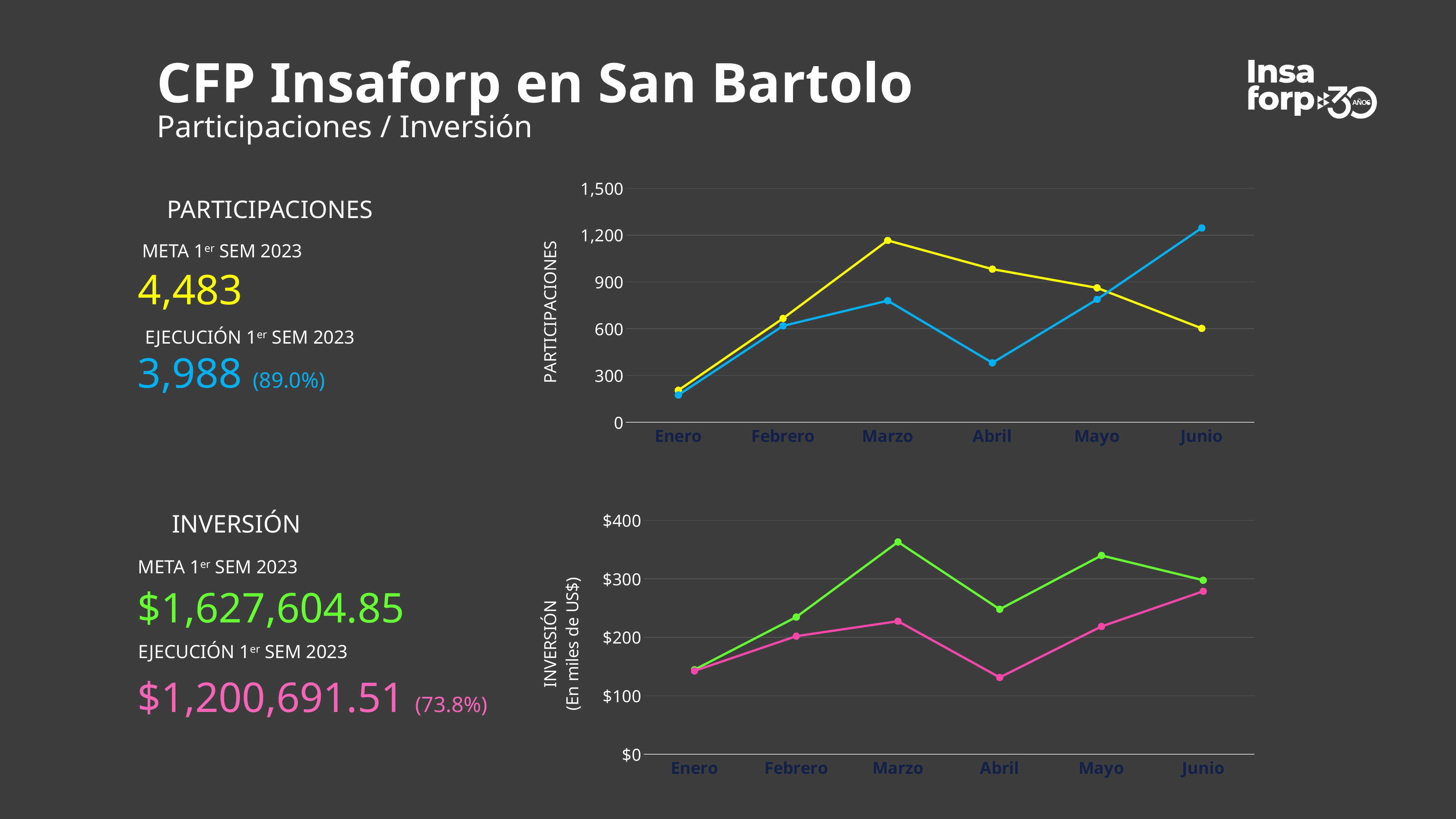
In the top chart (PARTICIPACIONES), does the yellow line rise or fall from Marzo to Junio? fall In the top chart (PARTICIPACIONES), in which month does the yellow line reach its highest value? Marzo In the top chart (PARTICIPACIONES), is the value of the blue line for Junio greater or less than 1,200? greater How many months are shown on the x axis of the bottom chart (INVERSIÓN)? 6 In the bottom chart (INVERSIÓN), is the value of the green line for Marzo greater or less than $300? greater In the bottom chart (INVERSIÓN), in which month does the pink line reach its lowest value? Abril What kind of chart is the top chart (PARTICIPACIONES)? line chart What is the y-axis title of the bottom chart? INVERSIÓN (En miles de US$) In the top chart (PARTICIPACIONES), which line is higher in Junio, the yellow line or the blue line? the blue line In the bottom chart (INVERSIÓN), in which month does the green line reach its highest value? Marzo In the top chart (PARTICIPACIONES), in which month does the blue line reach its highest value? Junio In the top chart (PARTICIPACIONES), is the value of the blue line for Abril greater or less than 600? less